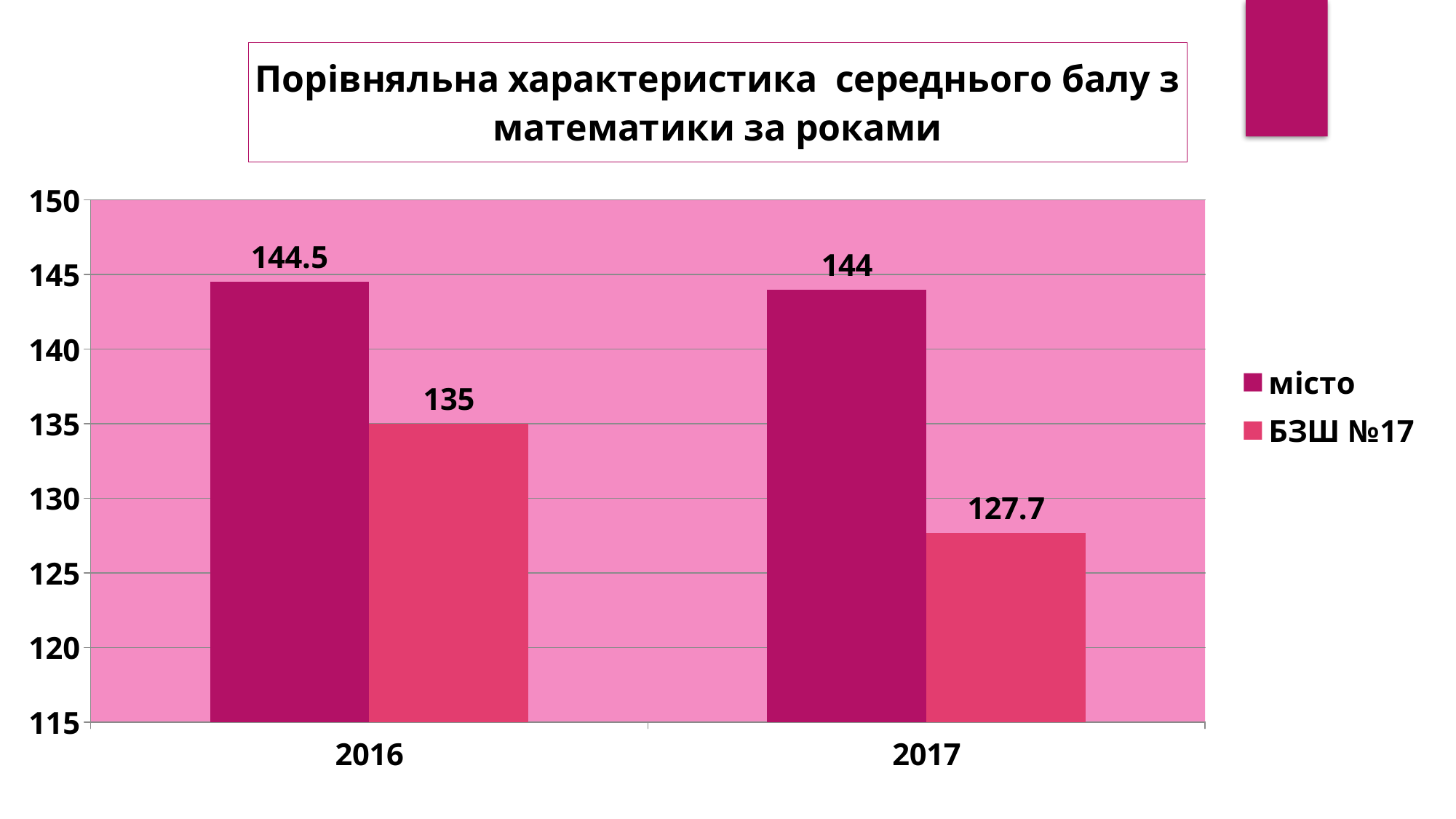
How many series does the legend list? 2 What is the value for БЗШ №17 in 2017? 127.7 Do the values for БЗШ №17 rise or fall from 2016 to 2017? fall What is the value for місто in 2017? 144 What kind of chart is shown on the slide? bar chart What is the value for місто in 2016? 144.5 Which is larger in 2016: місто or БЗШ №17? місто What is the difference between місто and БЗШ №17 in 2017? 16.3 What is the difference between the БЗШ №17 values for 2016 and 2017? 7.3 What is the value for БЗШ №17 in 2016? 135 How many years are shown on the x axis? 2 Which year has the lowest value for БЗШ №17? 2017